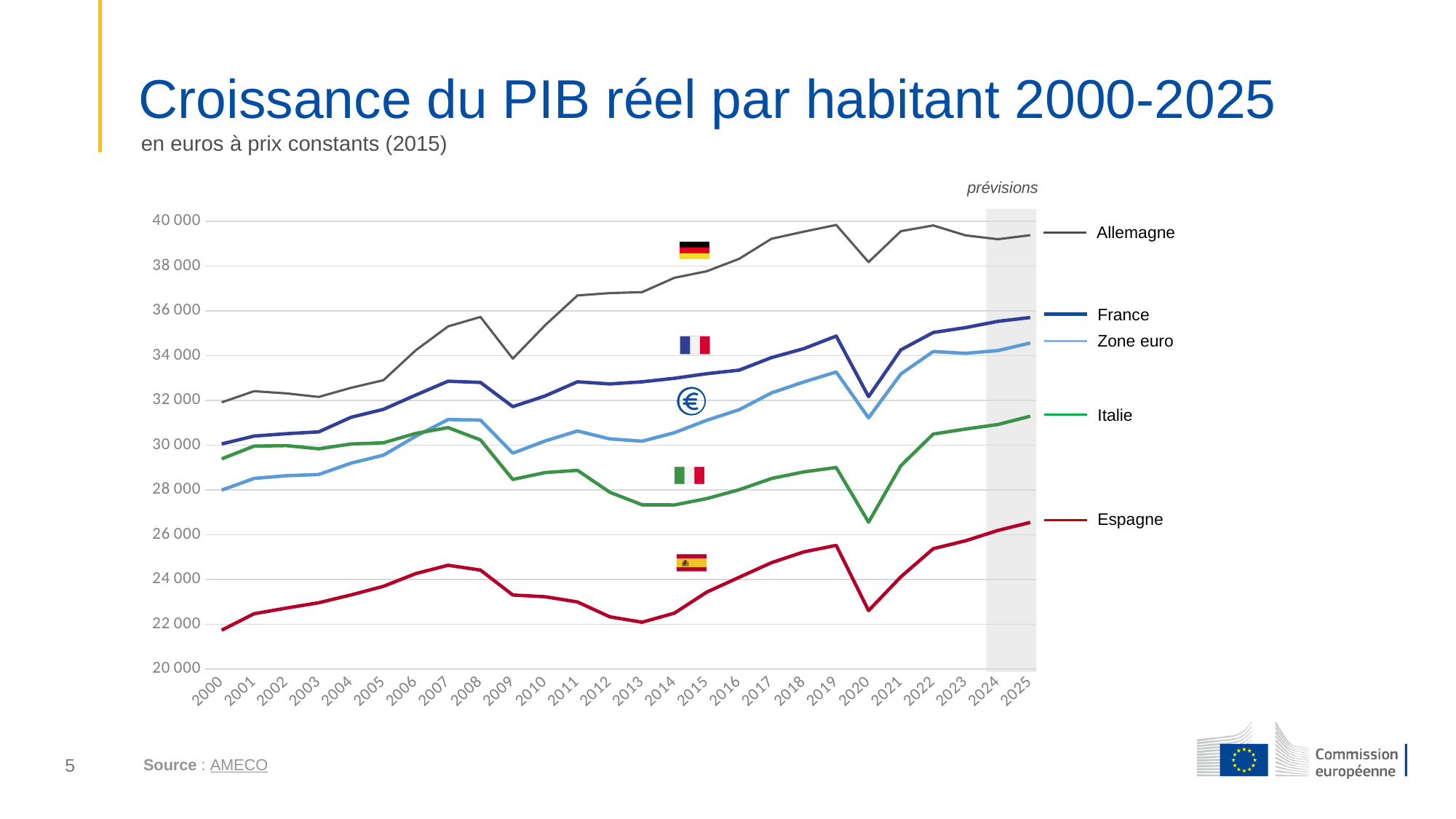
Is the value for Allemagne in 2019 greater or less than 38 000? greater Is the value for Espagne in 2000 greater or less than 22 000? less Which series has the lowest values throughout the chart? Espagne What is the title of the chart on the slide? Croissance du PIB réel par habitant 2000-2025 How many series does the legend list? 5 What kind of chart is shown on the slide? line chart Is the value for Italie in 2020 greater or less than 28 000? less Does the value for Espagne rise or fall from 2019 to 2020? fall How many years are plotted along the x axis? 26 In 2025, which is higher: France or Italie? France Which years are marked as 'prévisions' by the shaded area? 2024 and 2025 Which series has the highest values throughout the chart? Allemagne